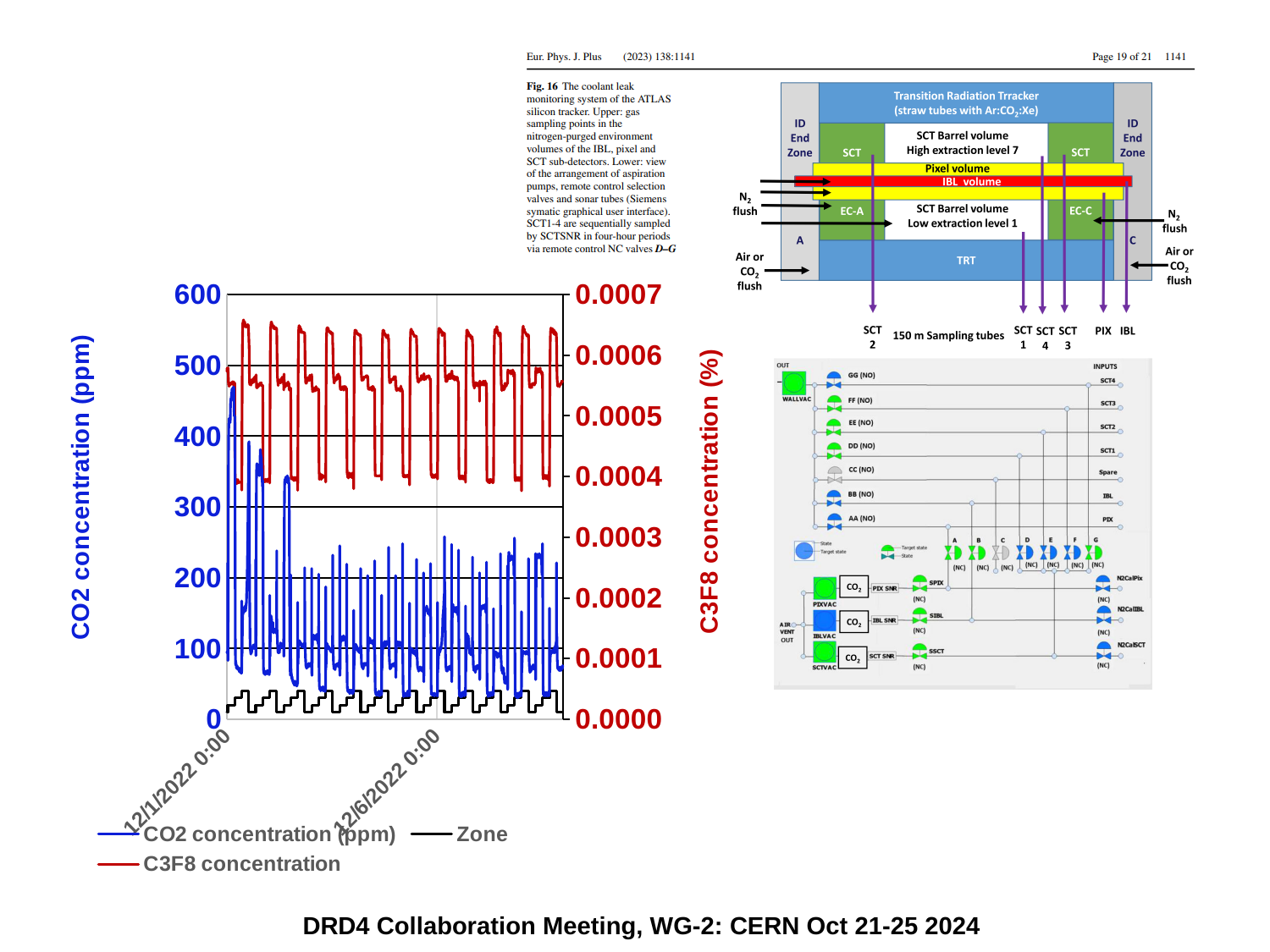
Is the lowest CO2 concentration on the chart greater or less than 100? less Is the highest CO2 concentration on the chart greater or less than 400? greater What kind of chart is shown on the slide? line chart Is the highest C3F8 concentration on the chart greater or less than 0.0006? greater What is the title of the left vertical axis of the chart? CO2 concentration (ppm) How many series does the chart's legend list? 3 Which series is drawn in red on the chart? C3F8 concentration